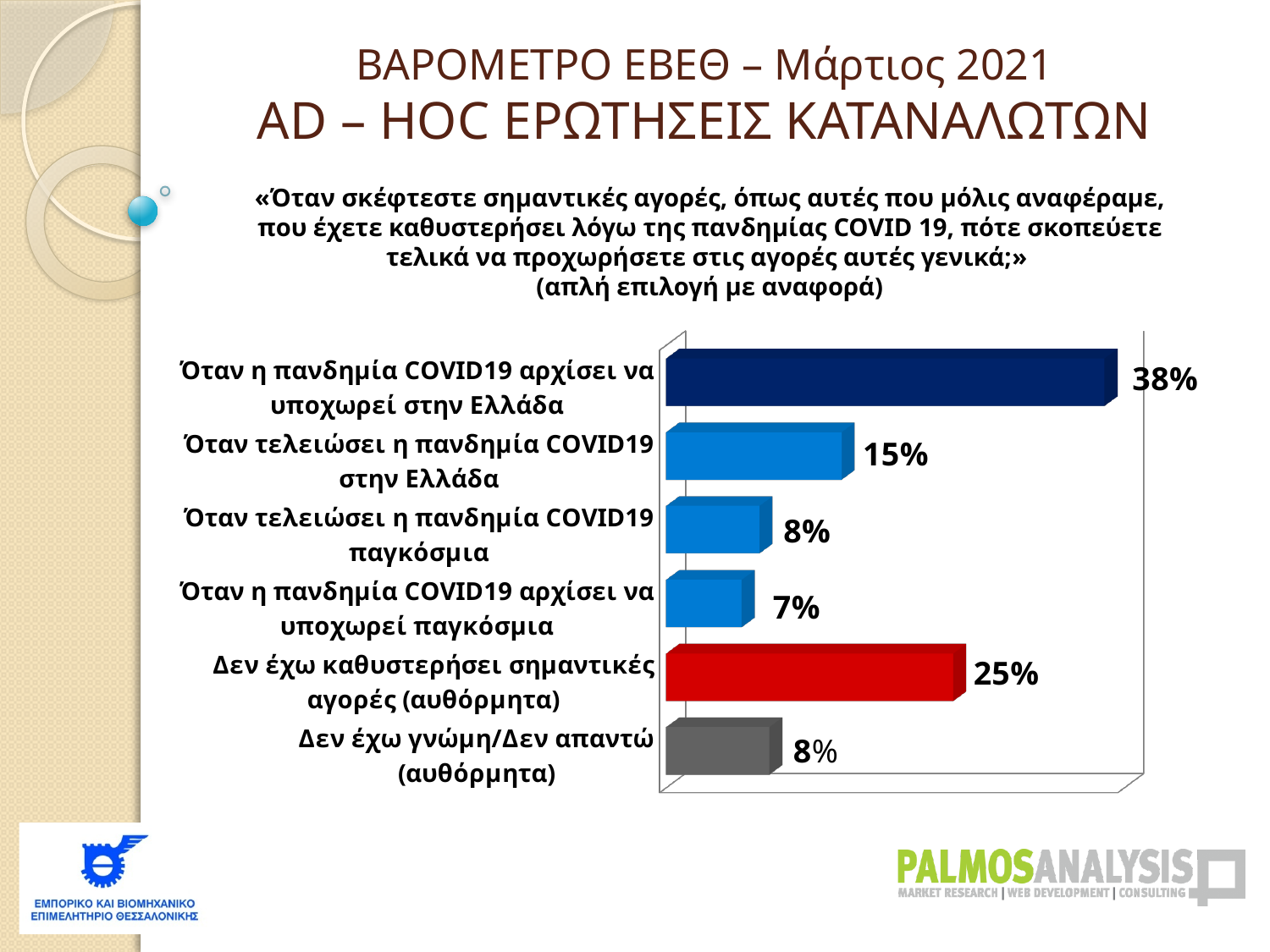
What is the difference between "Όταν η πανδημία COVID19 αρχίσει να υποχωρεί στην Ελλάδα" and "Δεν έχω καθυστερήσει σημαντικές αγορές (αυθόρμητα)"? 13% What is the value for "Δεν έχω καθυστερήσει σημαντικές αγορές (αυθόρμητα)"? 25% What colour is the bar for "Δεν έχω καθυστερήσει σημαντικές αγορές (αυθόρμητα)"? Red What is the value for "Όταν η πανδημία COVID19 αρχίσει να υποχωρεί παγκόσμια"? 7% What is the value for "Όταν η πανδημία COVID19 αρχίσει να υποχωρεί στην Ελλάδα"? 38% What is the value for "Δεν έχω γνώμη/Δεν απαντώ (αυθόρμητα)"? 8% What kind of chart is shown on the slide? Bar chart Which is larger: "Όταν τελειώσει η πανδημία COVID19 στην Ελλάδα" or "Όταν τελειώσει η πανδημία COVID19 παγκόσμια"? Όταν τελειώσει η πανδημία COVID19 στην Ελλάδα Which category has the highest value? Όταν η πανδημία COVID19 αρχίσει να υποχωρεί στην Ελλάδα What is the value for "Όταν τελειώσει η πανδημία COVID19 στην Ελλάδα"? 15% How many categories are shown in the chart? 6 Which category has the lowest value? Όταν η πανδημία COVID19 αρχίσει να υποχωρεί παγκόσμια